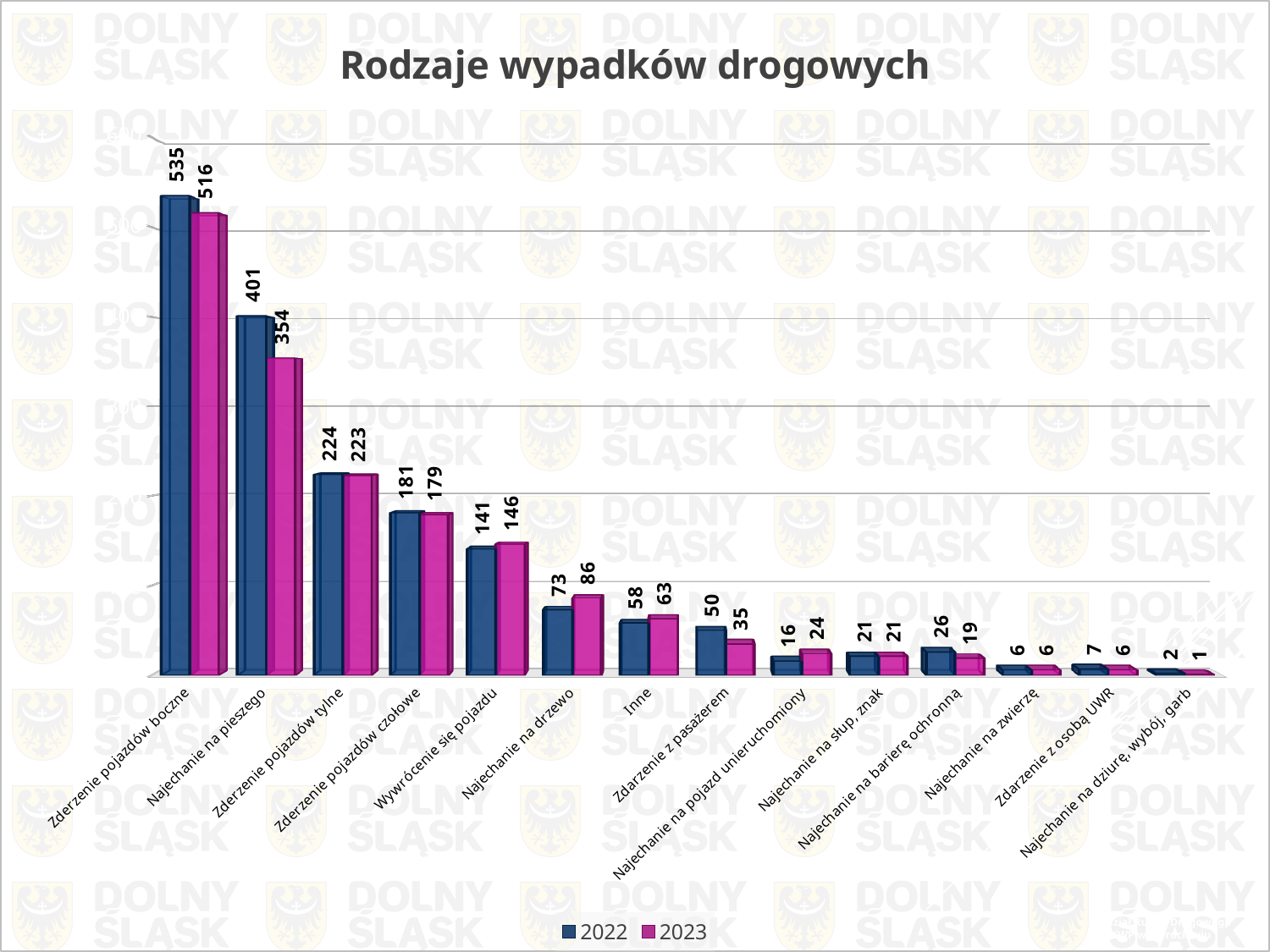
Which category has the lowest 2022 value? Najechanie na dziurę, wybój, garb What type of chart is shown on the slide? bar chart What is the difference between the 2022 and 2023 values for Najechanie na pojazd unieruchomiony? 8 How many accident categories are shown on the x axis? 14 What is the title of the chart? Rodzaje wypadków drogowych What is the difference between the 2022 and 2023 values for Najechanie na pieszego? 47 Which category has the highest 2023 value? Zderzenie pojazdów boczne What is the 2023 value for Zdarzenie z pasażerem? 35 What is the 2022 value for Najechanie na pieszego? 401 For Najechanie na drzewo, which year has the larger value, 2022 or 2023? 2023 What is the 2023 value for Wywrócenie się pojazdu? 146 How many series does the legend list? 2